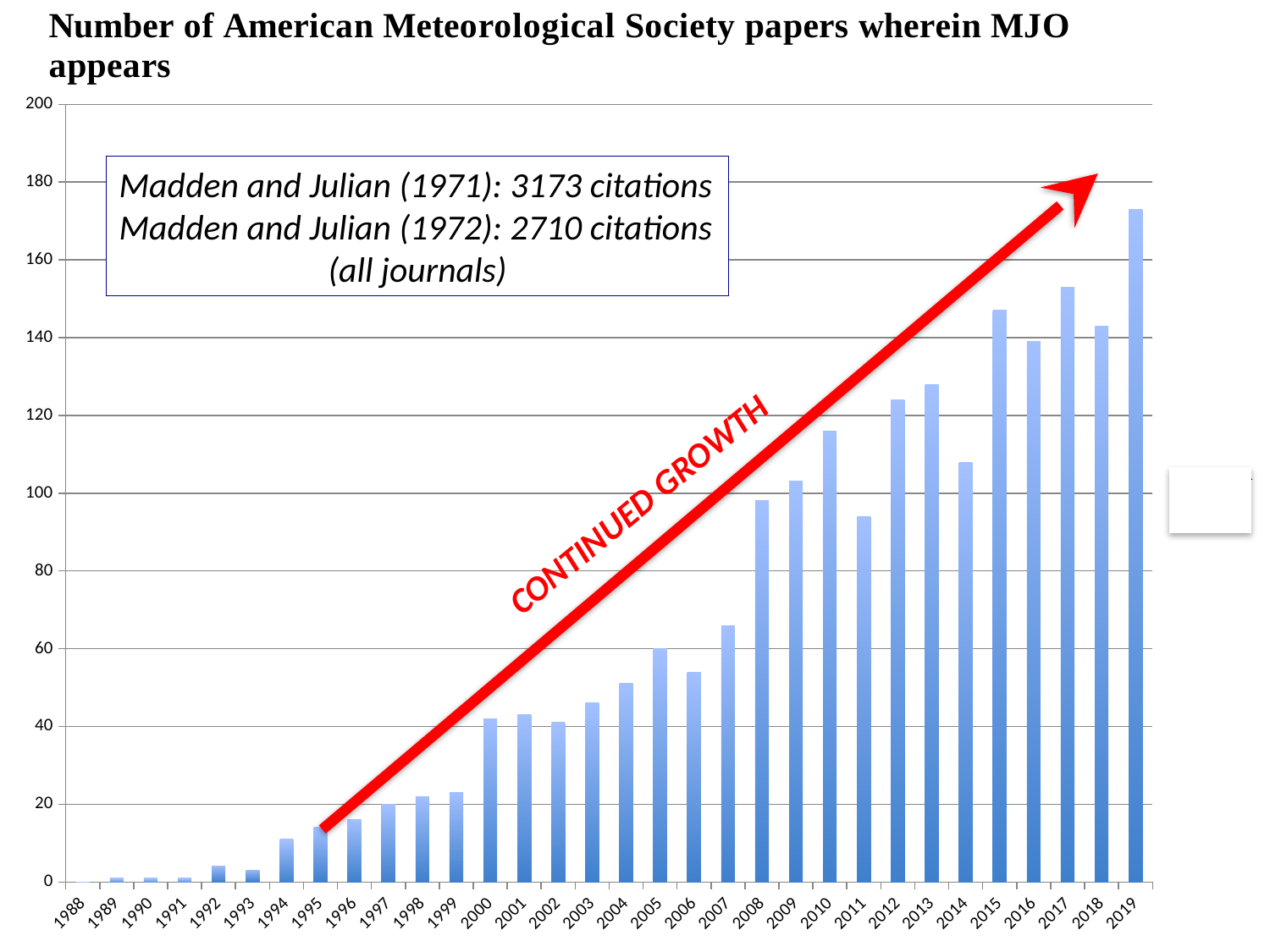
Is the value for 2004 greater or less than 40? greater Which year has the larger value, 2017 or 2018? 2017 How many years are shown on the x axis? 32 Which year has the larger value, 2010 or 2011? 2010 Is the value for 2007 greater or less than 60? greater Is the value for 2011 greater or less than 100? less Which year has the highest number of papers? 2019 What kind of chart is shown on the slide? bar chart What text is written along the red arrow on the chart? CONTINUED GROWTH Do the values generally rise or fall from 1988 to 2019? rise